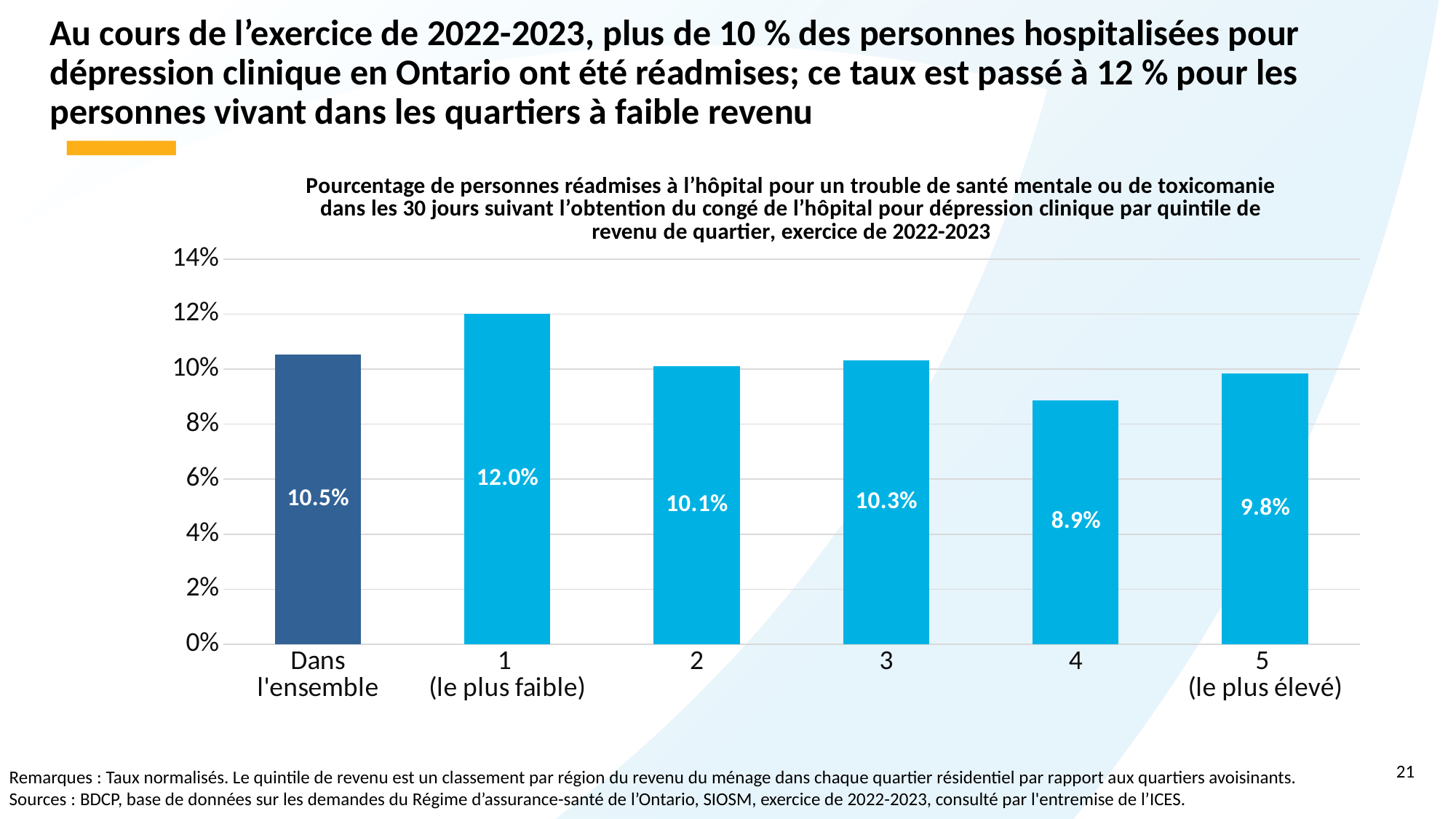
Which category has the highest value? 1 (le plus faible) Is the value for quintile 4 greater or less than 10%? less What is the value for 'Dans l'ensemble'? 10.5% Which bar is shown in a darker blue colour than the others? Dans l'ensemble What is the value for quintile 1 (le plus faible)? 12.0% Which is larger, the value for quintile 2 or the value for quintile 3? 3 Which category has the lowest value? 4 What is the difference between the values for quintile 1 (le plus faible) and quintile 5 (le plus élevé)? 2.2% What kind of chart is shown on the slide? bar chart How many bars are shown in the chart? 6 What is the value for quintile 5 (le plus élevé)? 9.8% What is the value for quintile 4? 8.9%